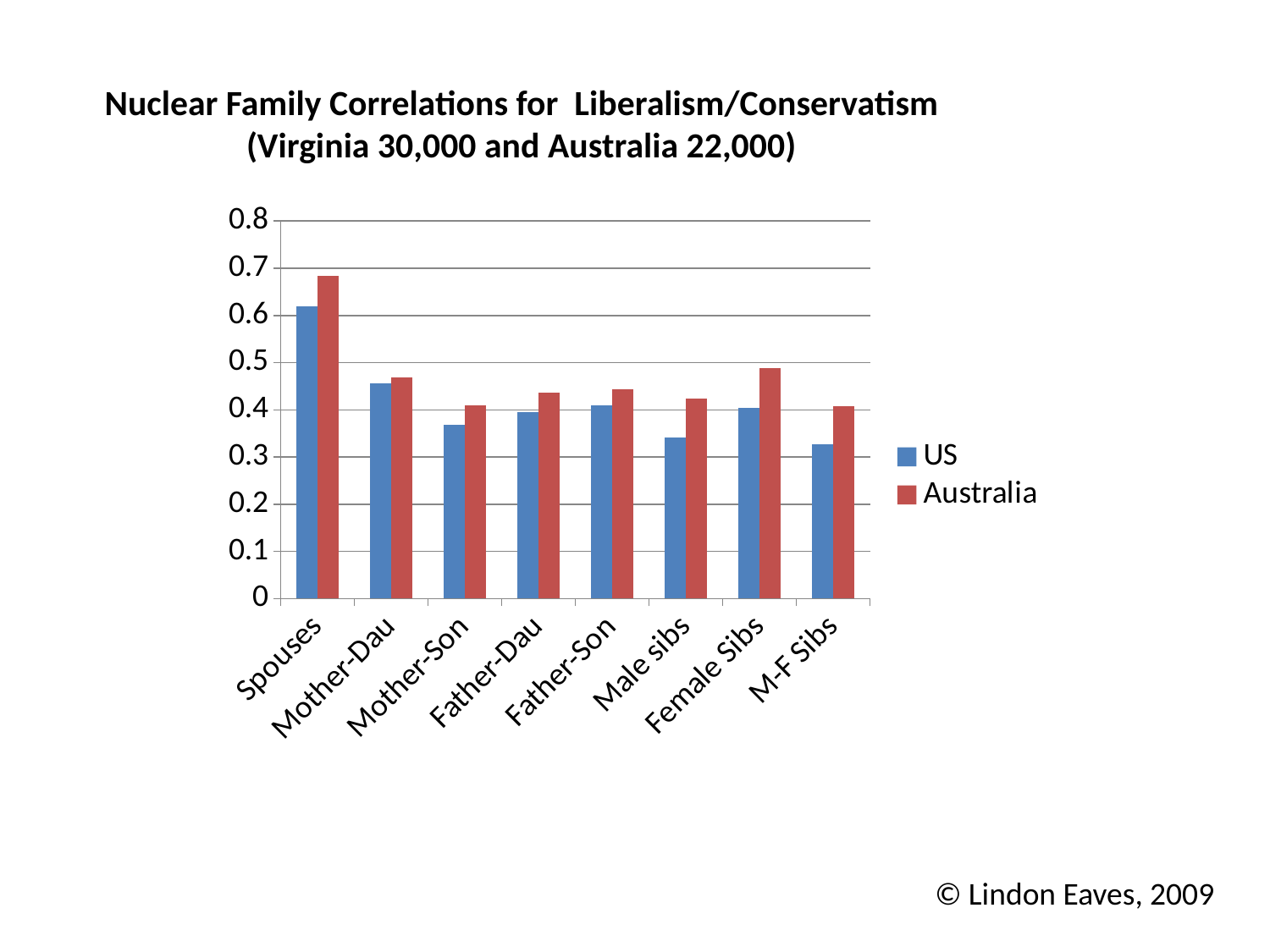
What are the two series named in the legend? US and Australia How many series does the legend list? 2 Is the Australia value for Female Sibs greater or less than 0.4? greater What kind of chart is shown on the slide? bar chart Which category has the highest Australia correlation? Spouses How many categories are shown on the x axis of the chart? 8 For Male sibs, which series has the larger value, US or Australia? Australia Which category has the highest US correlation? Spouses Is the US value for Male sibs greater or less than 0.4? less For Spouses, which series has the larger value, US or Australia? Australia Is the US value for M-F Sibs greater or less than 0.4? less